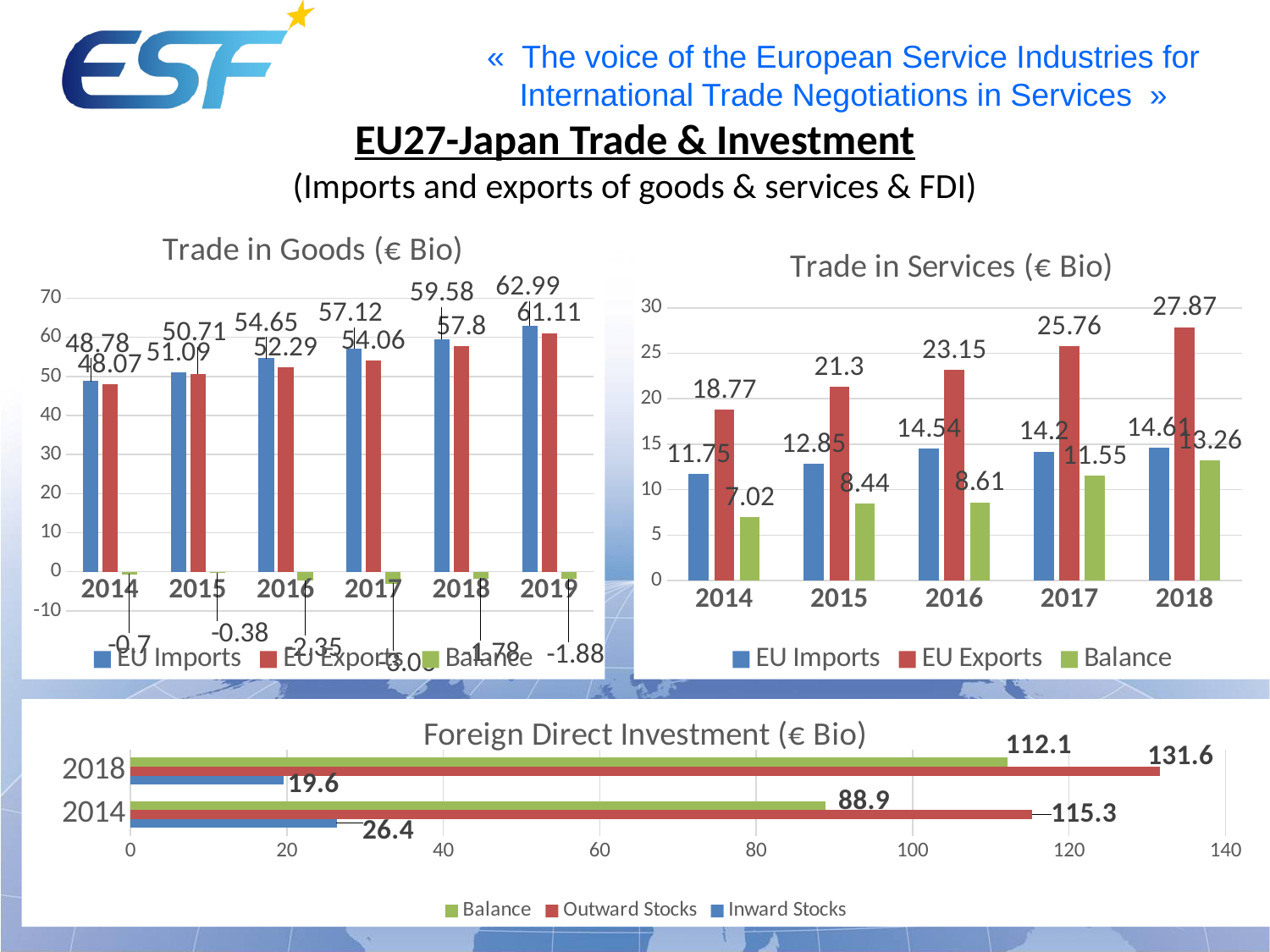
How many series does the legend of the Foreign Direct Investment chart list? 3 In the Trade in Services chart, do EU Exports rise or fall from 2014 to 2018? Rise How many years are shown on the x axis of the Trade in Goods chart? 6 In the Trade in Services chart, which year has the highest Balance? 2018 In the Foreign Direct Investment chart, what is the value of Inward Stocks for 2014? 26.4 In the Trade in Services chart, is the value of EU Exports for 2016 greater or less than 20? greater In the Trade in Services chart, what is the value of EU Exports for 2018? 27.87 What kind of chart is the Foreign Direct Investment chart? Bar chart In the Trade in Goods chart, what is the difference between EU Imports and EU Exports in 2018? 1.78 In the Foreign Direct Investment chart, which is larger: Outward Stocks in 2018 or Outward Stocks in 2014? Outward Stocks in 2018 In the Trade in Goods chart, what is the value of EU Imports for 2019? 62.99 In the Trade in Services chart, which year has the lowest EU Imports? 2014